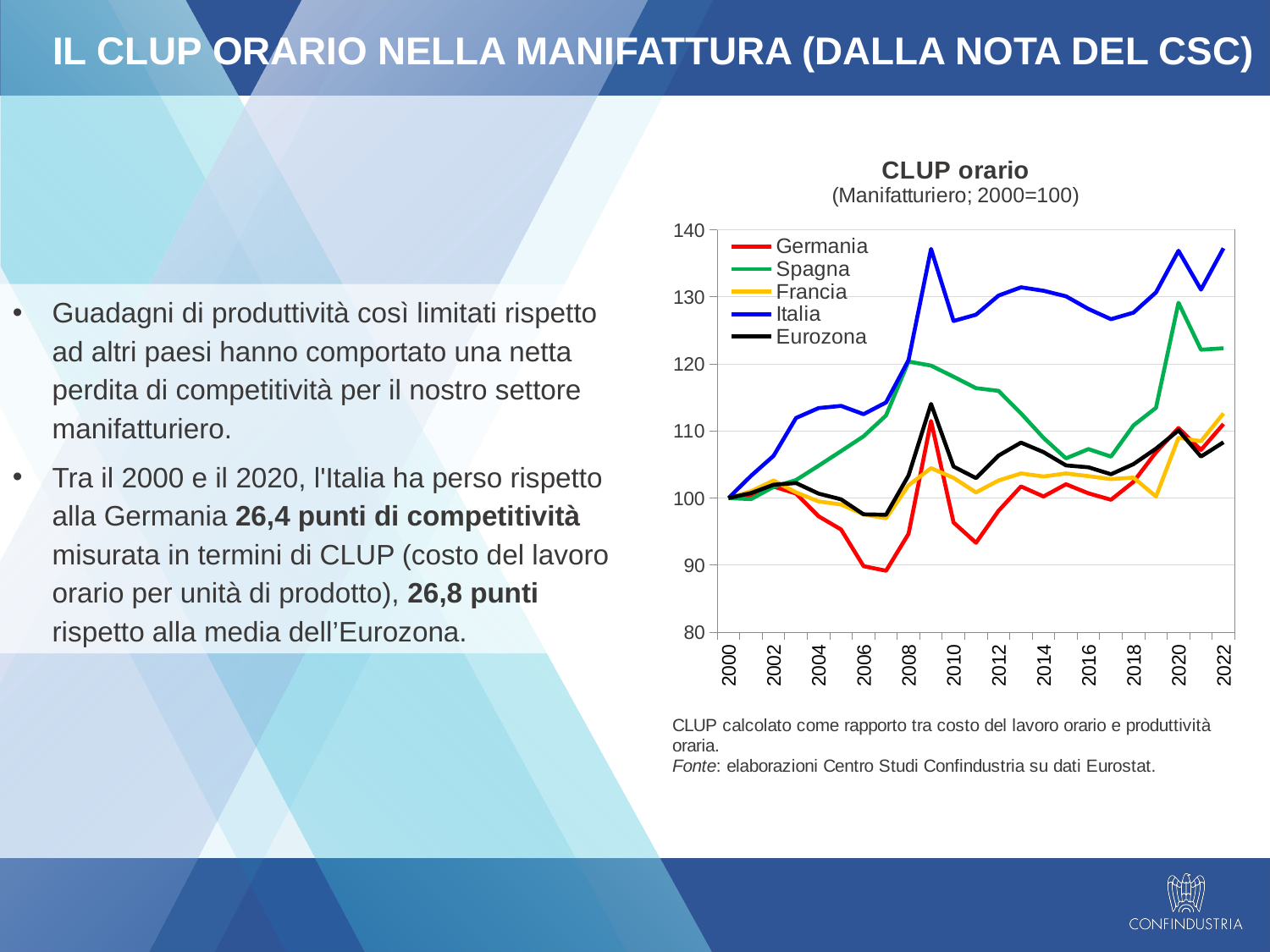
How many series does the legend of the CLUP orario chart list? 5 What is the subtitle shown under the chart title 'CLUP orario'? (Manifatturiero; 2000=100) Does the Italia series rise or fall between 2000 and 2009? rise Which series are listed in the legend of the CLUP orario chart? Germania, Spagna, Francia, Italia, Eurozona Is the value for Italia in 2009 greater or less than 130? greater Is the value for Spagna in 2020 greater or less than 120? greater Is the value for Germania in 2007 greater or less than 90? less In 2020, which is larger: the value for Italia or the value for Germania? Italia Which series has the highest value in 2022? Italia What is the value of the Italia series in 2000? 100 What kind of chart is shown on the slide? line chart Which series has the lowest value in 2007? Germania